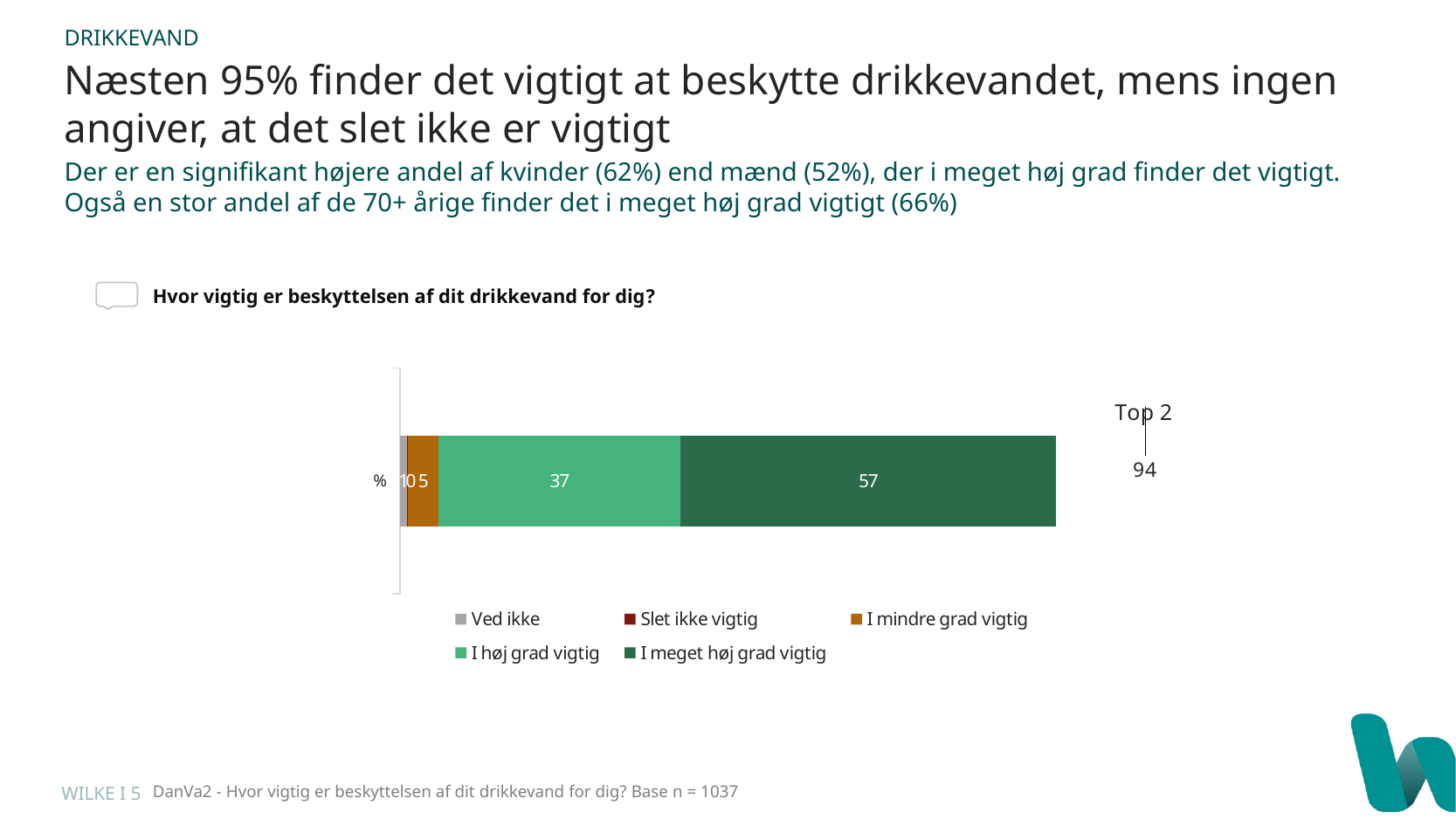
What is the value for "I høj grad vigtig"? 37 What is the value for "I mindre grad vigtig"? 5 What is the difference between the values for "I høj grad vigtig" and "I mindre grad vigtig"? 32 What is the difference between the values for "I meget høj grad vigtig" and "I høj grad vigtig"? 20 What is the Top 2 value shown next to the bar? 94 What kind of chart is shown on the slide? Stacked bar chart What is the value for "I meget høj grad vigtig"? 57 How many series does the legend list? 5 Which is larger, the value for "I høj grad vigtig" or the value for "I meget høj grad vigtig"? I meget høj grad vigtig Which response category has the largest segment in the bar? I meget høj grad vigtig What question is the chart based on, as shown above the chart? Hvor vigtig er beskyttelsen af dit drikkevand for dig? Which legend entry is shown in orange? I mindre grad vigtig